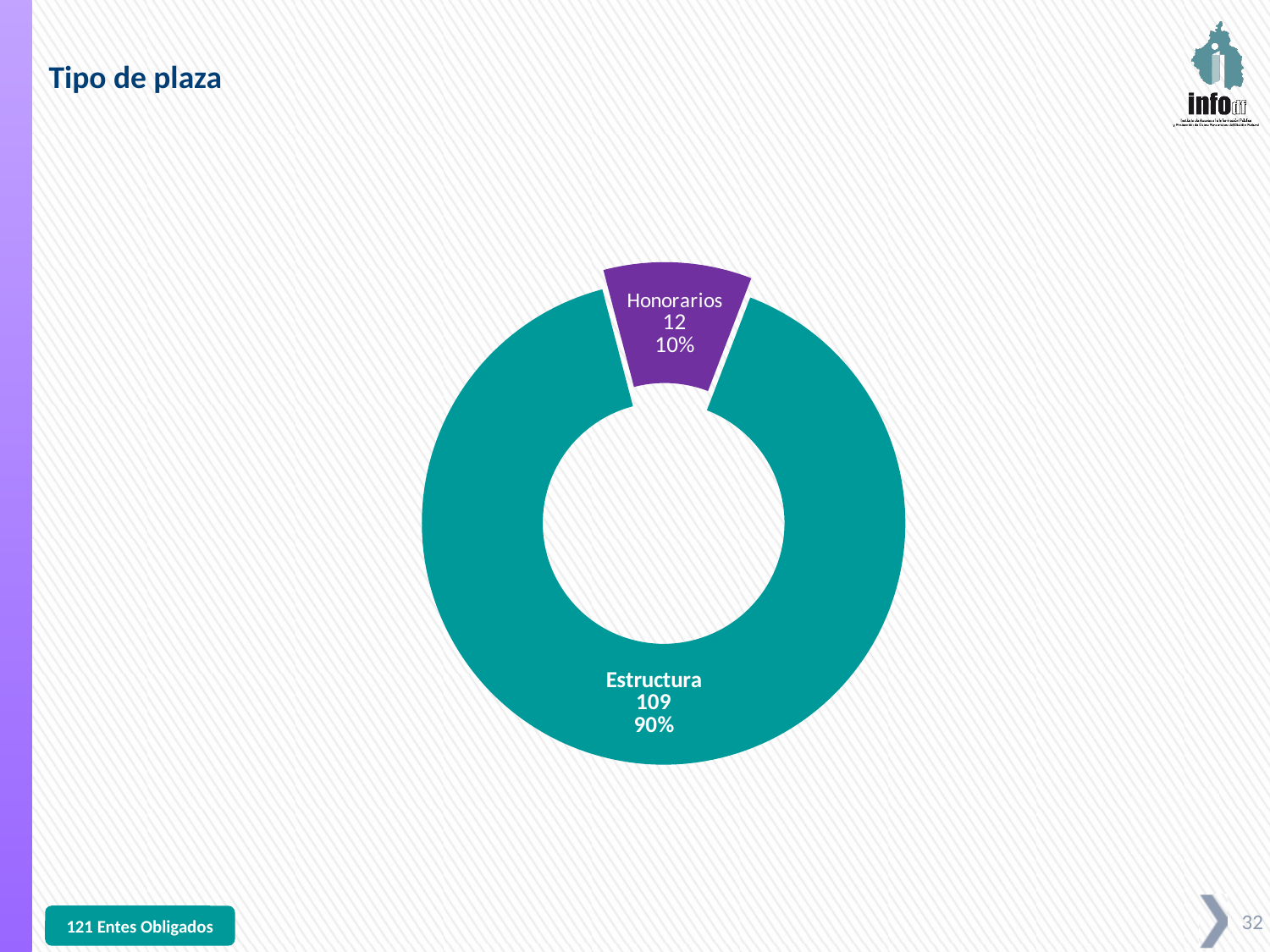
Which category has the highest value? Estructura What percentage share does Estructura have? 90% Which category has the lowest value? Honorarios What kind of chart is shown on the slide? Doughnut chart What is the difference between the values for Estructura and Honorarios? 97 What is the value for Honorarios? 12 What percentage share does Honorarios have? 10% What is the value for Estructura? 109 How many categories are shown in the chart? 2 Which is larger, Estructura or Honorarios? Estructura What is the total of the two values shown in the chart? 121 What is the title of the slide? Tipo de plaza